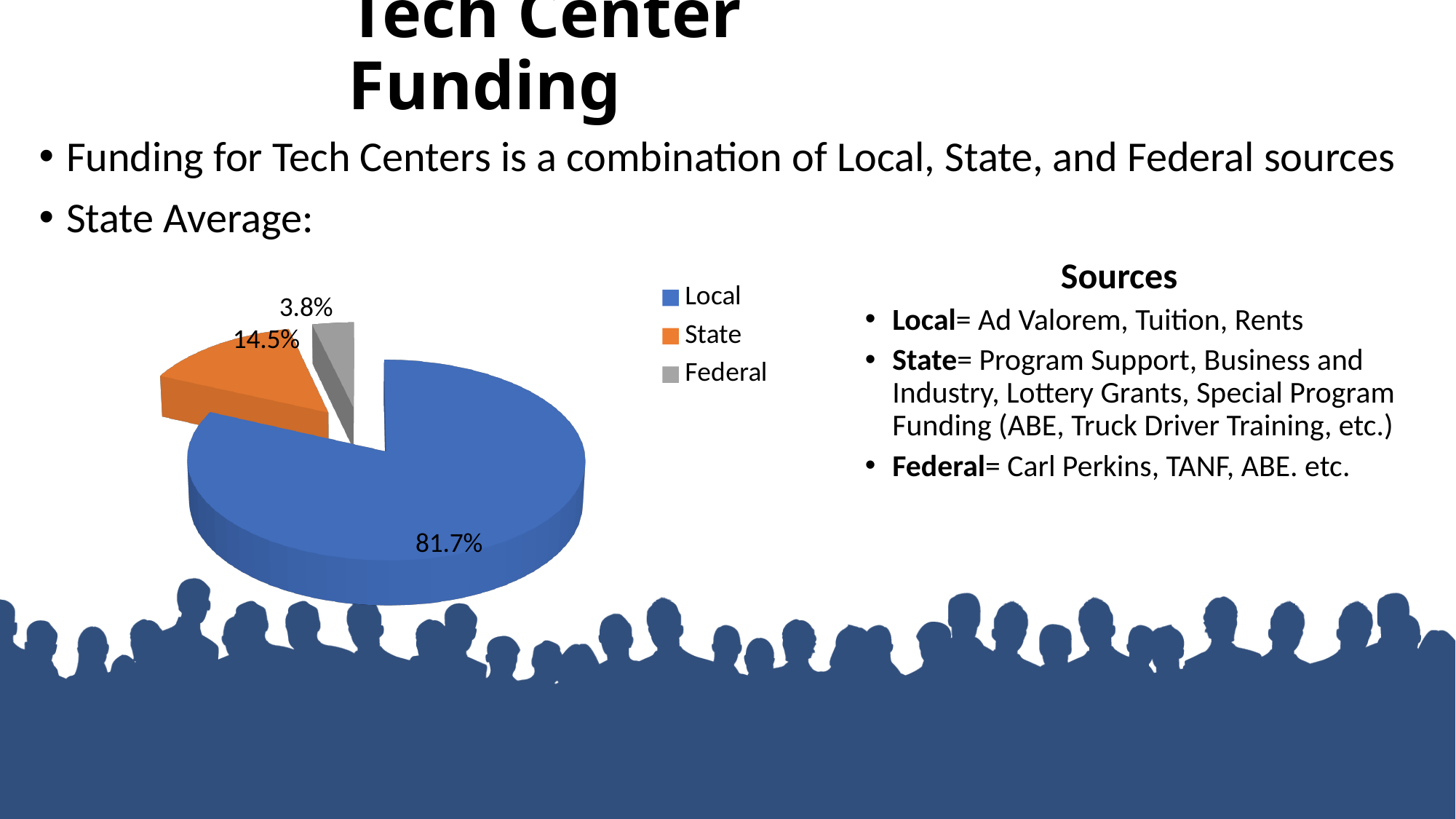
Which funding source has the smallest slice in the pie chart? Federal What share of Tech Center funding comes from Federal sources according to the pie chart? 3.8% What colour is the State slice in the pie chart? Orange What share of Tech Center funding comes from State sources according to the pie chart? 14.5% Which is larger in the pie chart, the State slice or the Federal slice? State Which legend entry is shown in grey? Federal What share of Tech Center funding comes from Local sources according to the pie chart? 81.7% What type of chart is shown on the slide? Pie chart Which funding source has the largest slice in the pie chart? Local How many slices does the pie chart have? 3 What is the difference in percentage points between the Local and State slices? 67.2 What is the difference in percentage points between the State and Federal slices? 10.7